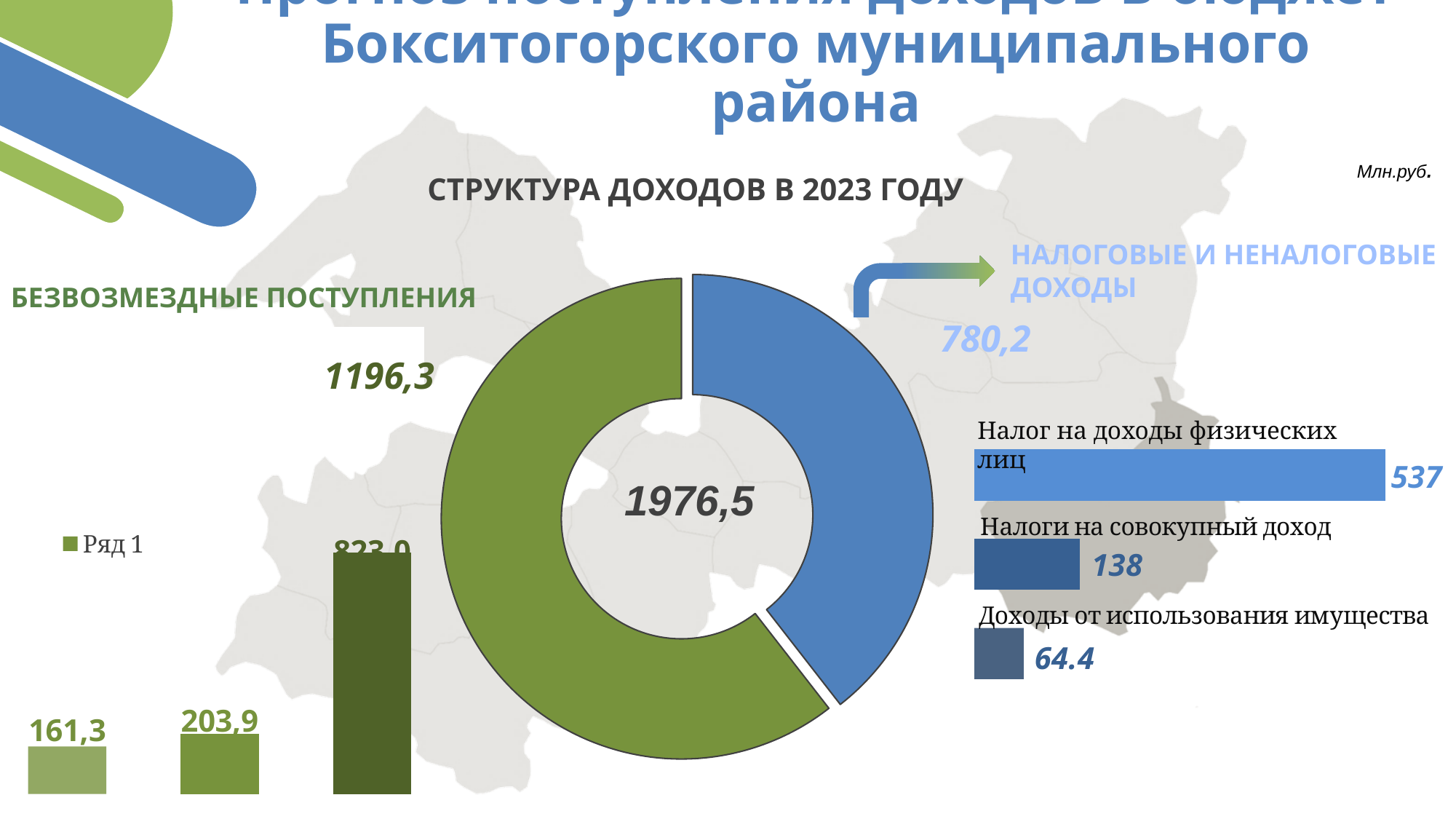
In the donut chart 'СТРУКТУРА ДОХОДОВ В 2023 ГОДУ', how many slices are there? 2 In the horizontal bar chart on the right of the slide, which category has the lowest value? Доходы от использования имущества In the vertical bar chart at the bottom left of the slide, how many bars are there? 3 In the donut chart 'СТРУКТУРА ДОХОДОВ В 2023 ГОДУ', what is the value for НАЛОГОВЫЕ И НЕНАЛОГОВЫЕ ДОХОДЫ? 780,2 In the horizontal bar chart on the right of the slide, what is the value for Доходы от использования имущества? 64.4 In the horizontal bar chart on the right of the slide, what is the value for Налог на доходы физических лиц? 537 In the donut chart 'СТРУКТУРА ДОХОДОВ В 2023 ГОДУ', what is the value for БЕЗВОЗМЕЗДНЫЕ ПОСТУПЛЕНИЯ? 1196,3 In the donut chart 'СТРУКТУРА ДОХОДОВ В 2023 ГОДУ', which slice is larger: БЕЗВОЗМЕЗДНЫЕ ПОСТУПЛЕНИЯ or НАЛОГОВЫЕ И НЕНАЛОГОВЫЕ ДОХОДЫ? БЕЗВОЗМЕЗДНЫЕ ПОСТУПЛЕНИЯ In the donut chart 'СТРУКТУРА ДОХОДОВ В 2023 ГОДУ', what total is shown in the centre? 1976,5 In the horizontal bar chart on the right of the slide, what is the difference between Налог на доходы физических лиц and Налоги на совокупный доход? 399 In the horizontal bar chart on the right of the slide, what is the value for Налоги на совокупный доход? 138 In the donut chart 'СТРУКТУРА ДОХОДОВ В 2023 ГОДУ', what is the difference between БЕЗВОЗМЕЗДНЫЕ ПОСТУПЛЕНИЯ and НАЛОГОВЫЕ И НЕНАЛОГОВЫЕ ДОХОДЫ? 416,1